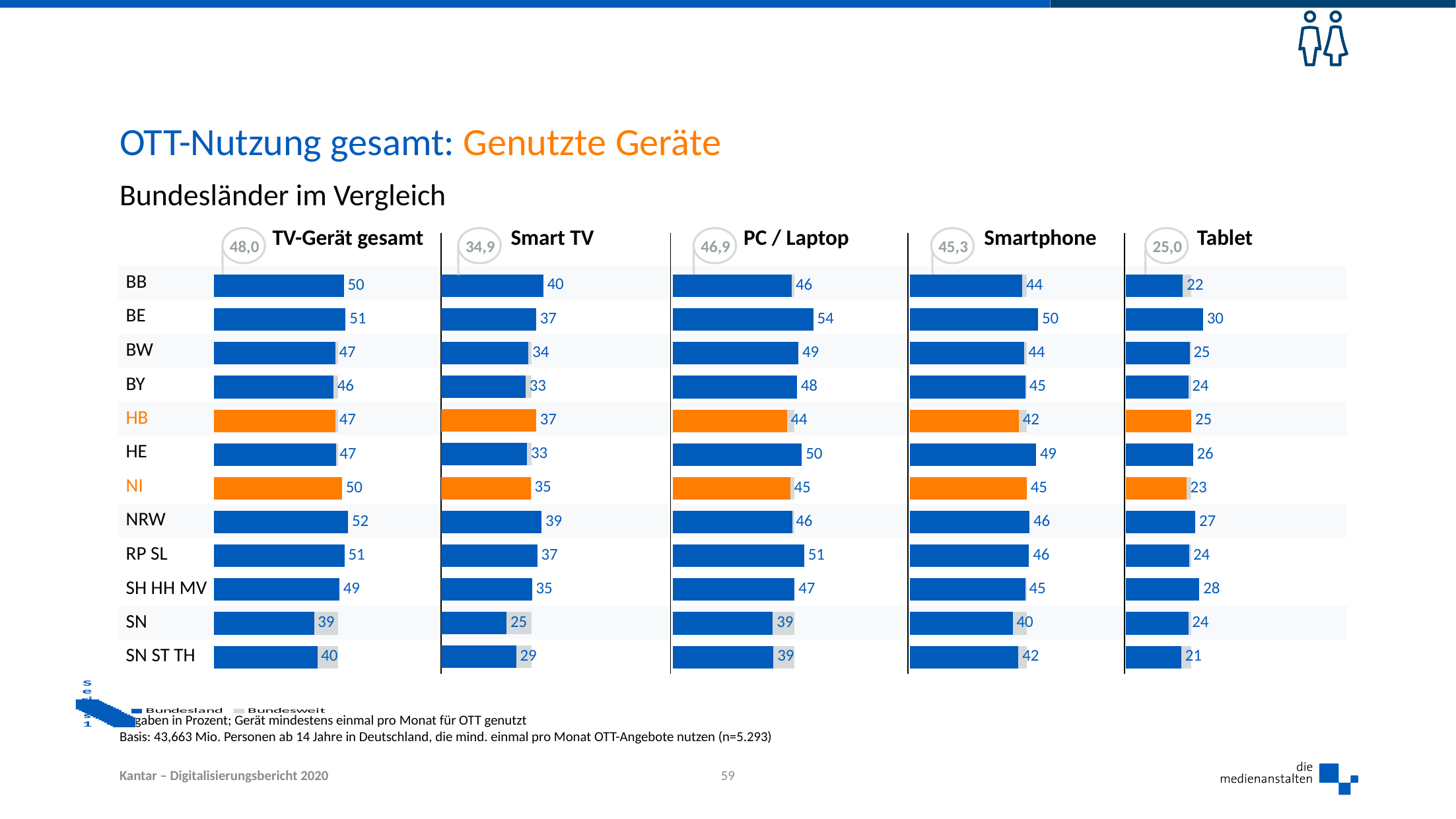
In the Smart TV chart, what is the value for SN? 25 In the Tablet chart, what is the difference between the values for BE and SN ST TH? 9 In the TV-Gerät gesamt chart, what is the value for NRW? 52 In the Smartphone chart, which Bundesland has the lowest value? SN What kind of chart is used for the Smartphone data? bar chart In the TV-Gerät gesamt chart, which Bundesland has the lowest value? SN How many Bundesländer (categories) are shown in the TV-Gerät gesamt chart? 12 In the Smart TV chart, which Bundesland has the highest value? BB In the PC / Laptop chart, which Bundesland has the highest value? BE What is the Bundesweit (nationwide) value shown for PC / Laptop? 46,9 In the PC / Laptop chart, which is larger, the value for HE or the value for HB? HE In the Tablet chart, what is the value for SH HH MV? 28